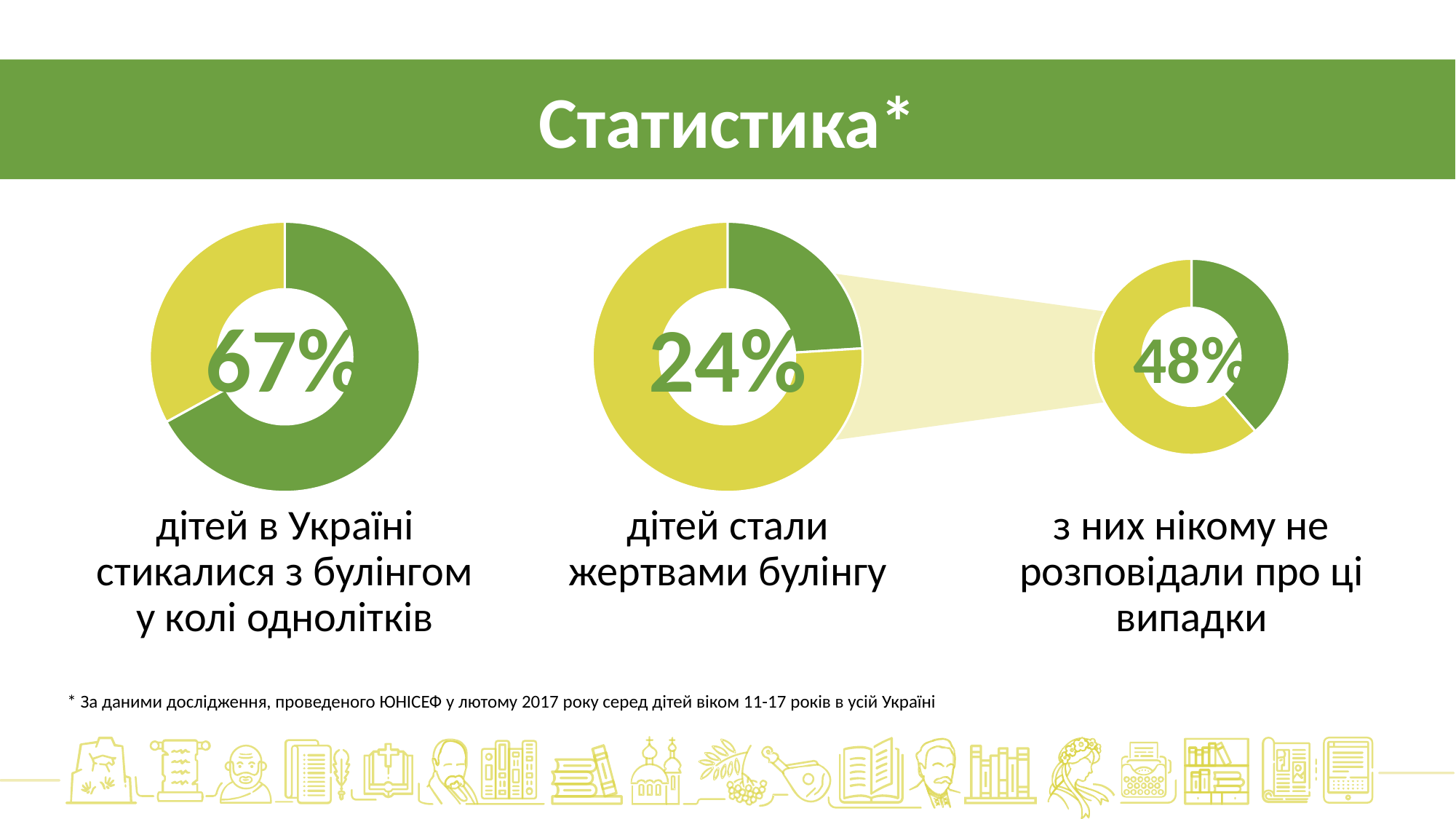
What is the title of the slide containing the charts? Статистика* Which of the three donut charts shows the lowest percentage? The middle chart (24%) What percentage is shown in the right donut chart (з них нікому не розповідали про ці випадки)? 48% Is the percentage in the right chart (48%) larger or smaller than the percentage in the left chart (67%)? Smaller In the left donut chart, what share of the ring does the dark green slice represent? 67% What percentage is shown in the left donut chart (дітей в Україні стикалися з булінгом у колі однолітків)? 67% What kind of charts are shown on the slide? Donut (pie) charts How many donut charts are on the slide? 3 What percentage is shown in the middle donut chart (дітей стали жертвами булінгу)? 24% What is the difference between the percentage in the right chart (48%) and the middle chart (24%)? 24 percentage points What is the difference between the percentage in the left chart (67%) and the middle chart (24%)? 43 percentage points Which of the three donut charts shows the highest percentage? The left chart (67%)